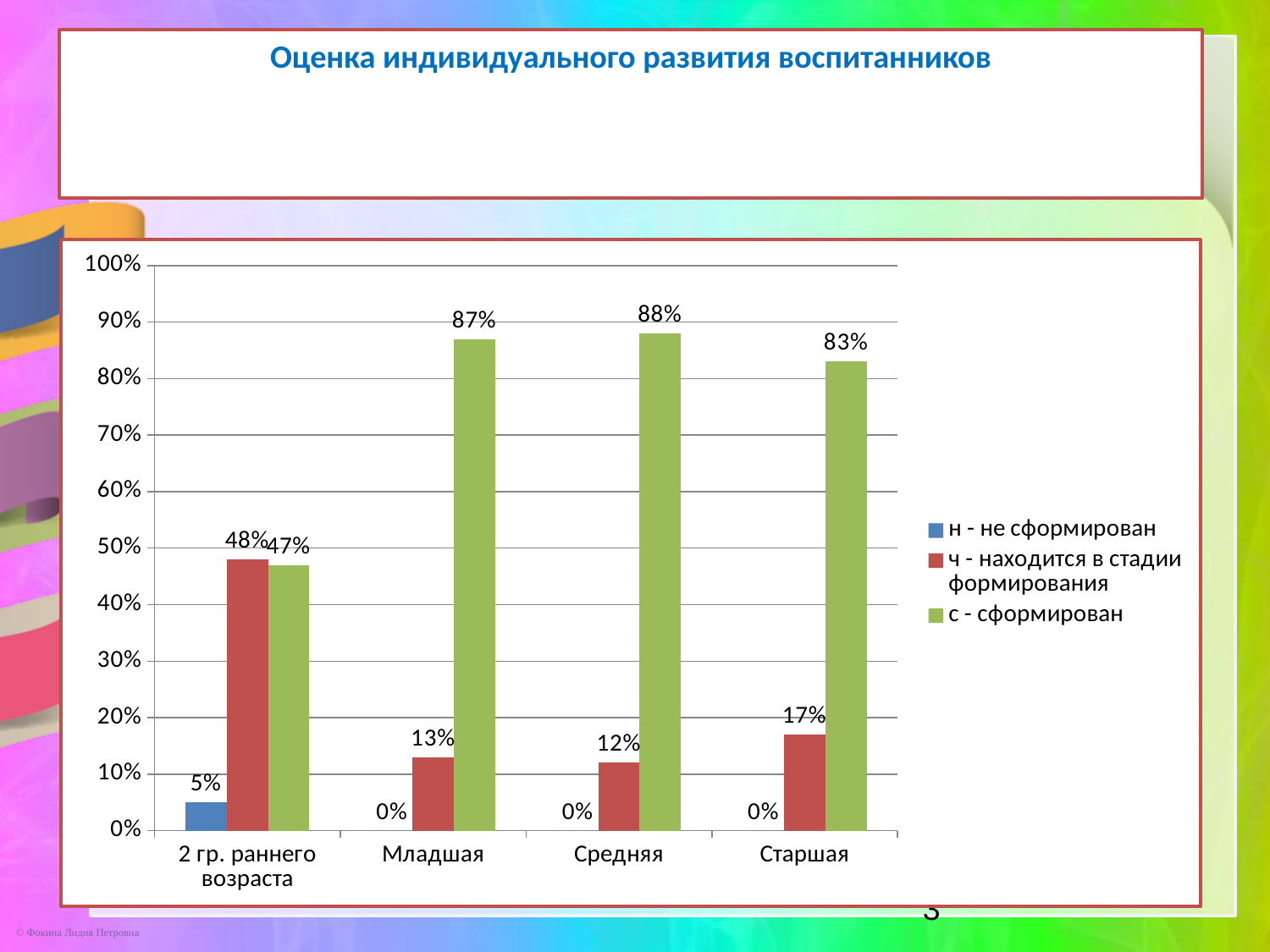
What kind of chart is shown on the slide? Bar chart What is the value for "н - не сформирован" in the "2 гр. раннего возраста" group? 5% What is the value for "с - сформирован" in the Младшая group? 87% How many series does the legend list? 3 Which group has the highest value for "с - сформирован"? Средняя What is the value for "н - не сформирован" in the Средняя group? 0% How many groups are shown on the x axis? 4 What is the value for "ч - находится в стадии формирования" in the Старшая group? 17% What is the title of the slide? Оценка индивидуального развития воспитанников What is the difference between the "с - сформирован" values for Средняя and Старшая? 5% Which group has the lowest value for "с - сформирован"? 2 гр. раннего возраста Which is larger in the "2 гр. раннего возраста" group: "ч - находится в стадии формирования" or "с - сформирован"? ч - находится в стадии формирования